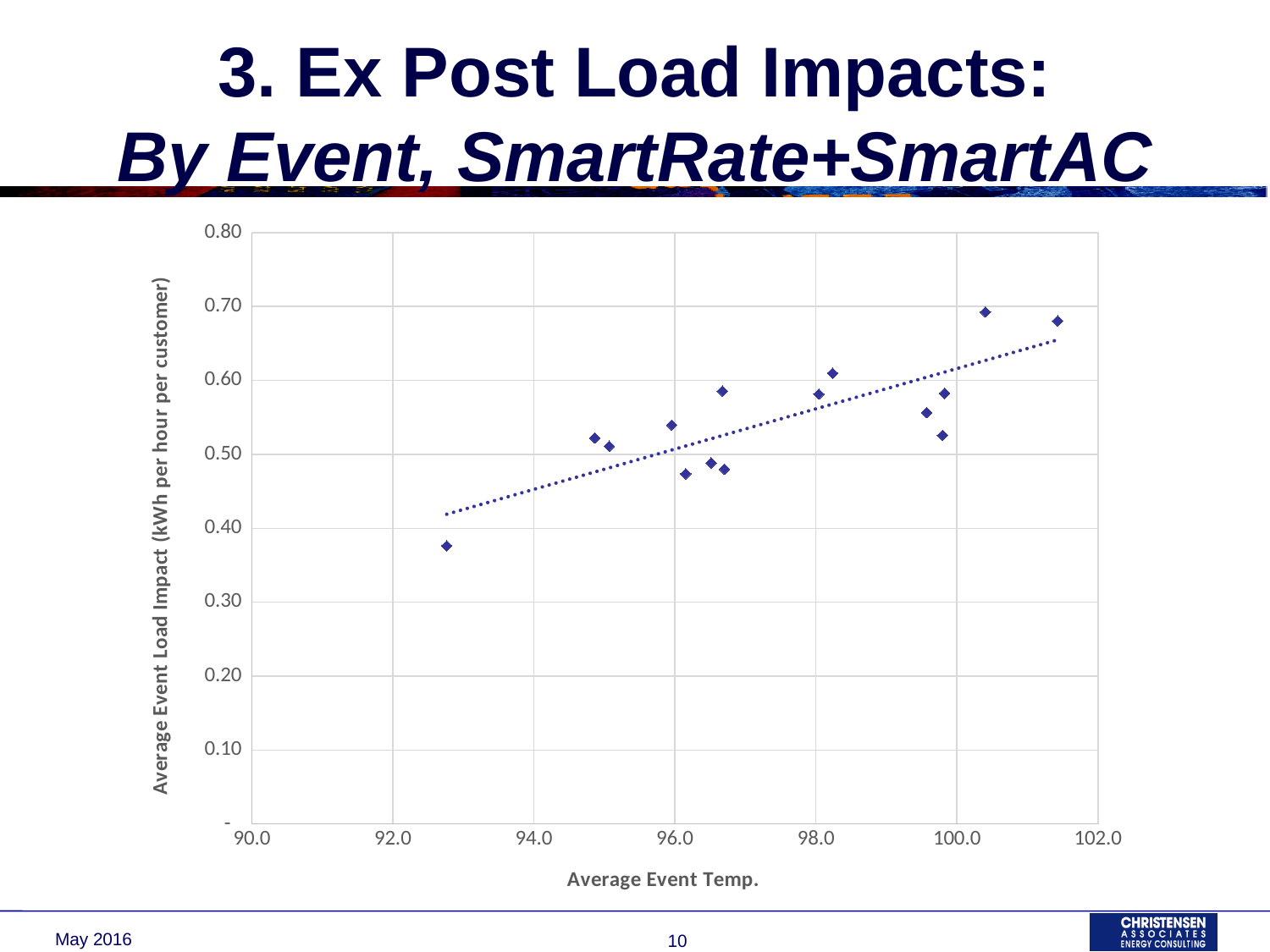
Which has the larger load impact: the event at about 92.8 degrees or the event at about 100.4 degrees? The event at about 100.4 degrees What is the highest value shown on the y axis? 0.80 Is the load impact for the event with the highest average temperature (near 101.5) greater or less than 0.60? greater Is the load impact for the event with the lowest average temperature (near 92.8) greater or less than 0.40? less As average event temperature increases along the x axis, does the average event load impact generally rise or fall? Rise Does the dotted trend line slope upward or downward from left to right? Upward Is the load impact for the event at about 98.3 degrees greater or less than 0.50? greater What is the title of the y axis of the chart? Average Event Load Impact (kWh per hour per customer) How many data points are plotted on the chart? 15 What kind of chart is shown on the slide? Scatter chart What is the title of the x axis of the chart? Average Event Temp.